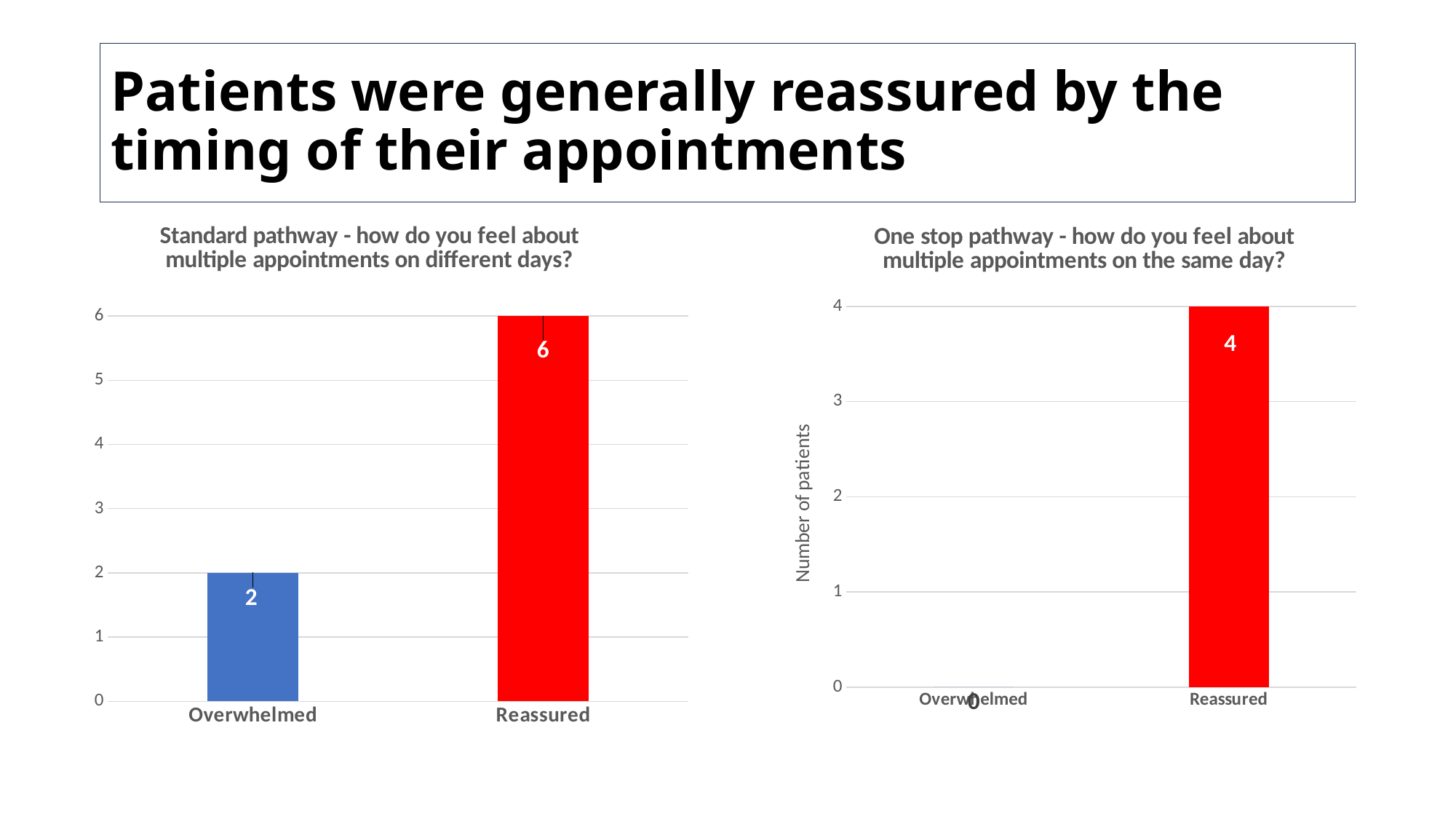
In the 'Standard pathway' chart, how many patients said they felt Reassured? 6 In the 'One stop pathway' chart, how many patients said they felt Overwhelmed? 0 In the 'One stop pathway' chart, which category has the lowest value? Overwhelmed In the 'Standard pathway' chart, which is larger: the value for Overwhelmed or the value for Reassured? Reassured How many categories are shown in the 'One stop pathway' chart? 2 In the 'Standard pathway' chart, how many patients said they felt Overwhelmed? 2 In the 'One stop pathway' chart, what is the difference between the Reassured and Overwhelmed values? 4 What type of chart is the 'Standard pathway' chart? Bar chart In the 'One stop pathway' chart, how many patients said they felt Reassured? 4 What is the y-axis label of the 'One stop pathway' chart? Number of patients In the 'Standard pathway' chart, what is the difference between the Reassured and Overwhelmed values? 4 In the 'Standard pathway' chart, which category has the highest value? Reassured